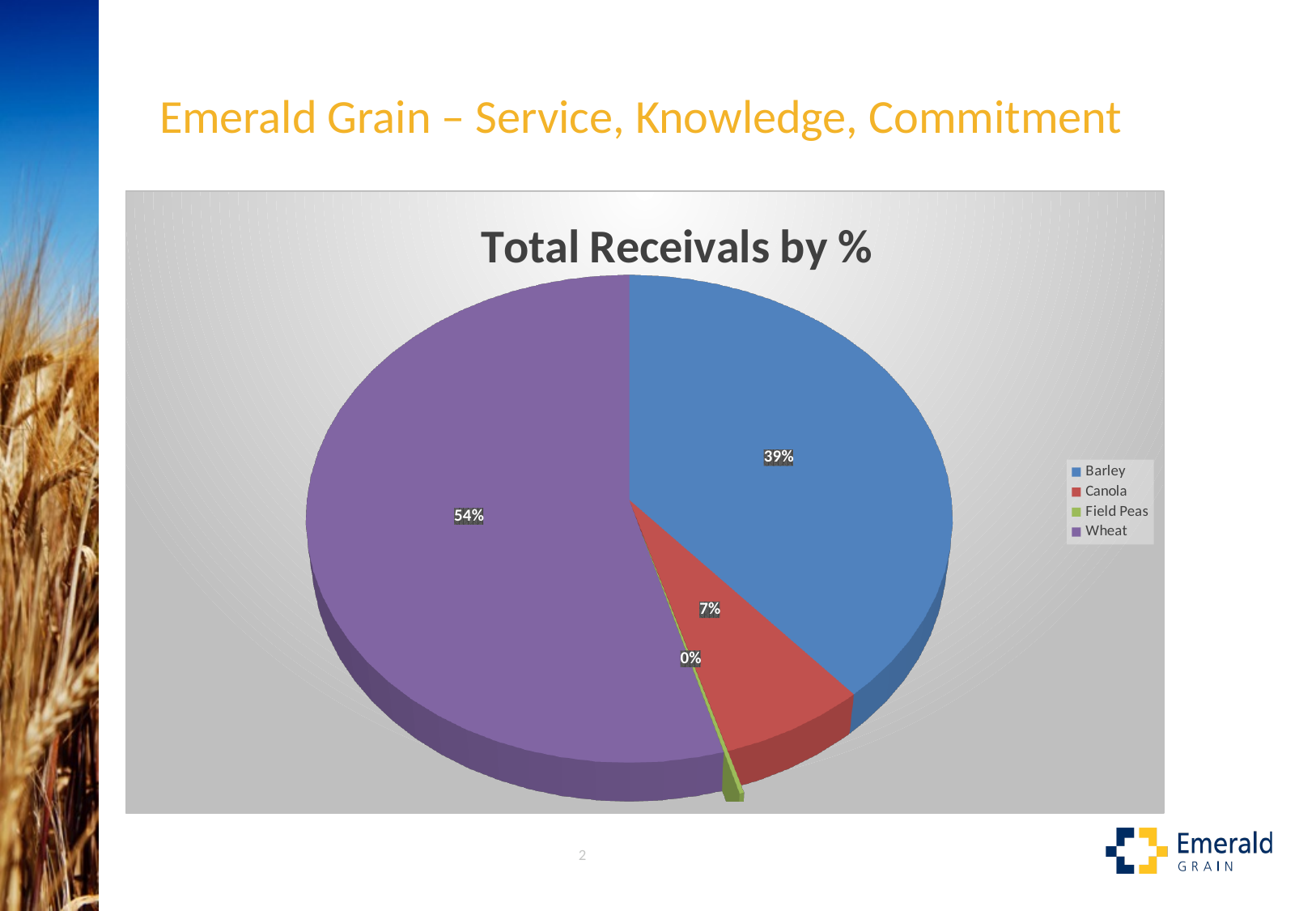
What share of total receivals is Barley? 39% What colour is the Wheat slice? purple Which has a larger share, Barley or Canola? Barley Which category has the smallest share of total receivals? Field Peas What share of total receivals is Wheat? 54% What kind of chart is shown on the slide? pie chart What share of total receivals is Field Peas? 0% What is the title of the chart? Total Receivals by % How many categories does the legend list? 4 Which category has the largest share of total receivals? Wheat What is the difference in percentage points between the Wheat and Barley shares? 15